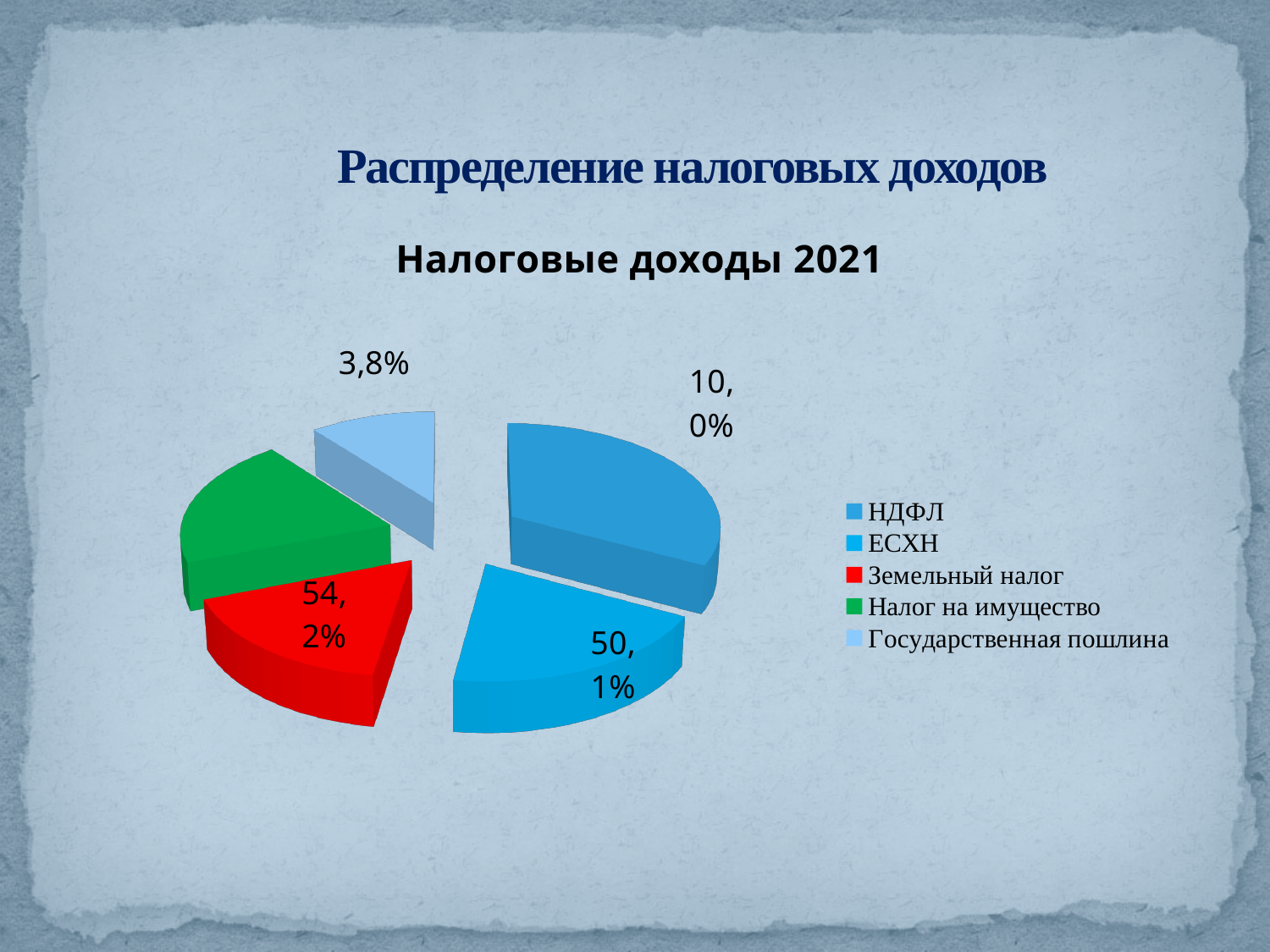
What value is labelled for НДФЛ? 10,0% What value is labelled for ЕСХН? 50,1% How many categories does the legend of the pie chart list? 5 What value is labelled for Земельный налог? 54,2% What is the difference between the labelled values for НДФЛ and Государственная пошлина? 6,2% Which category is shown in red in the pie chart? Земельный налог Which has the larger labelled value, НДФЛ or Государственная пошлина? НДФЛ What value is labelled for Государственная пошлина? 3,8% Which has the larger labelled value, Земельный налог or ЕСХН? Земельный налог What is the difference between the labelled values for Земельный налог and ЕСХН? 4,1% What kind of chart is shown on the slide? pie chart What is the title of the chart? Налоговые доходы 2021